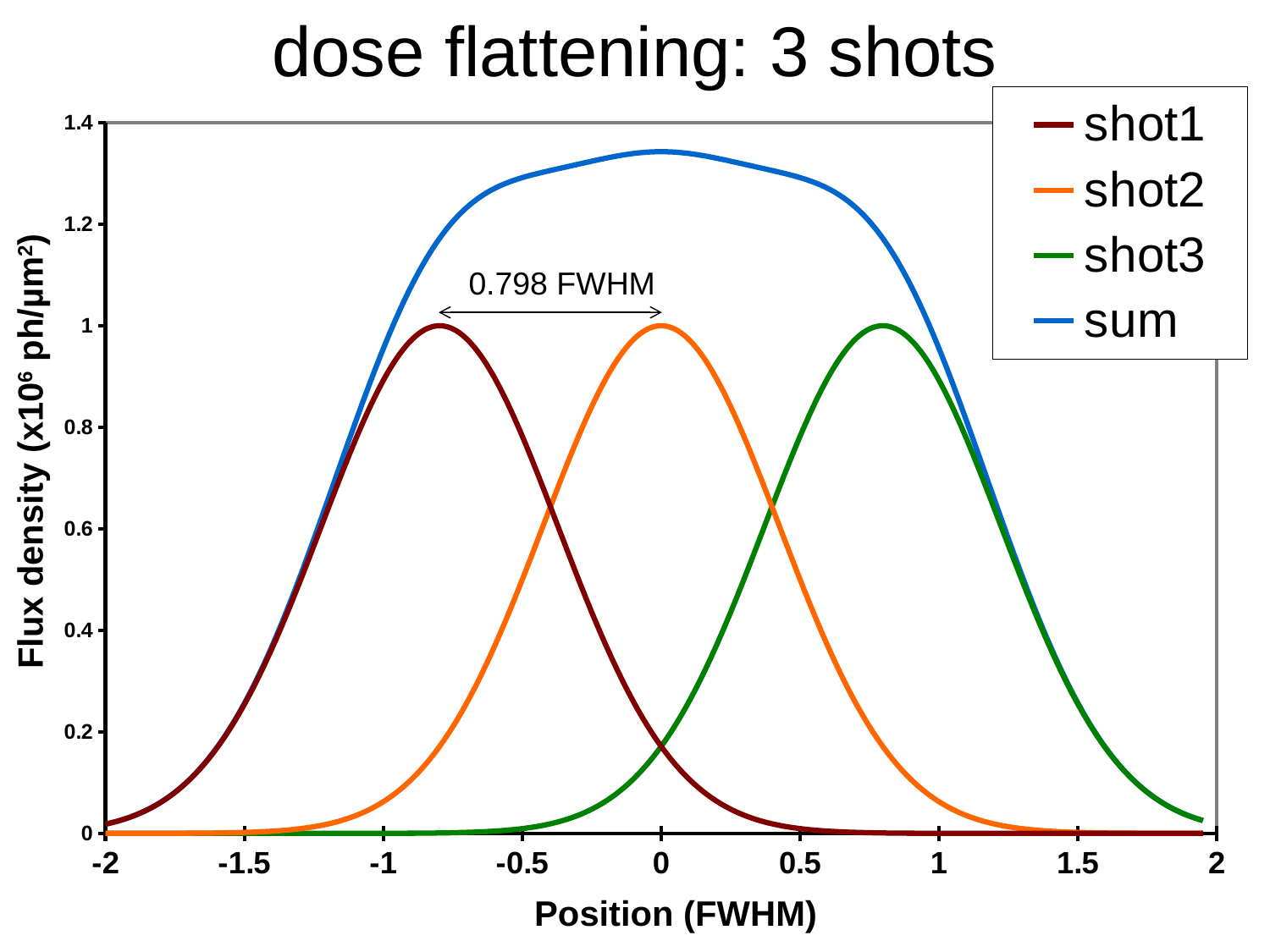
What kind of chart is shown on the slide? line chart Which series reaches the highest value on the chart? sum Is the peak value of the sum series greater or less than 1.2? greater Does the shot3 series rise or fall as position increases from 1 to 2? fall What is the label of the x axis? Position (FWHM) How many series does the legend list? 4 What is the label of the y axis? Flux density (x10⁶ ph/μm²) Is the peak value of the sum series greater or less than 1.4? less At position 0, which is larger: shot2 or shot1? shot2 What spacing between shot peaks is annotated on the chart? 0.798 FWHM What is the title of the chart? dose flattening: 3 shots Which series is drawn in blue? sum